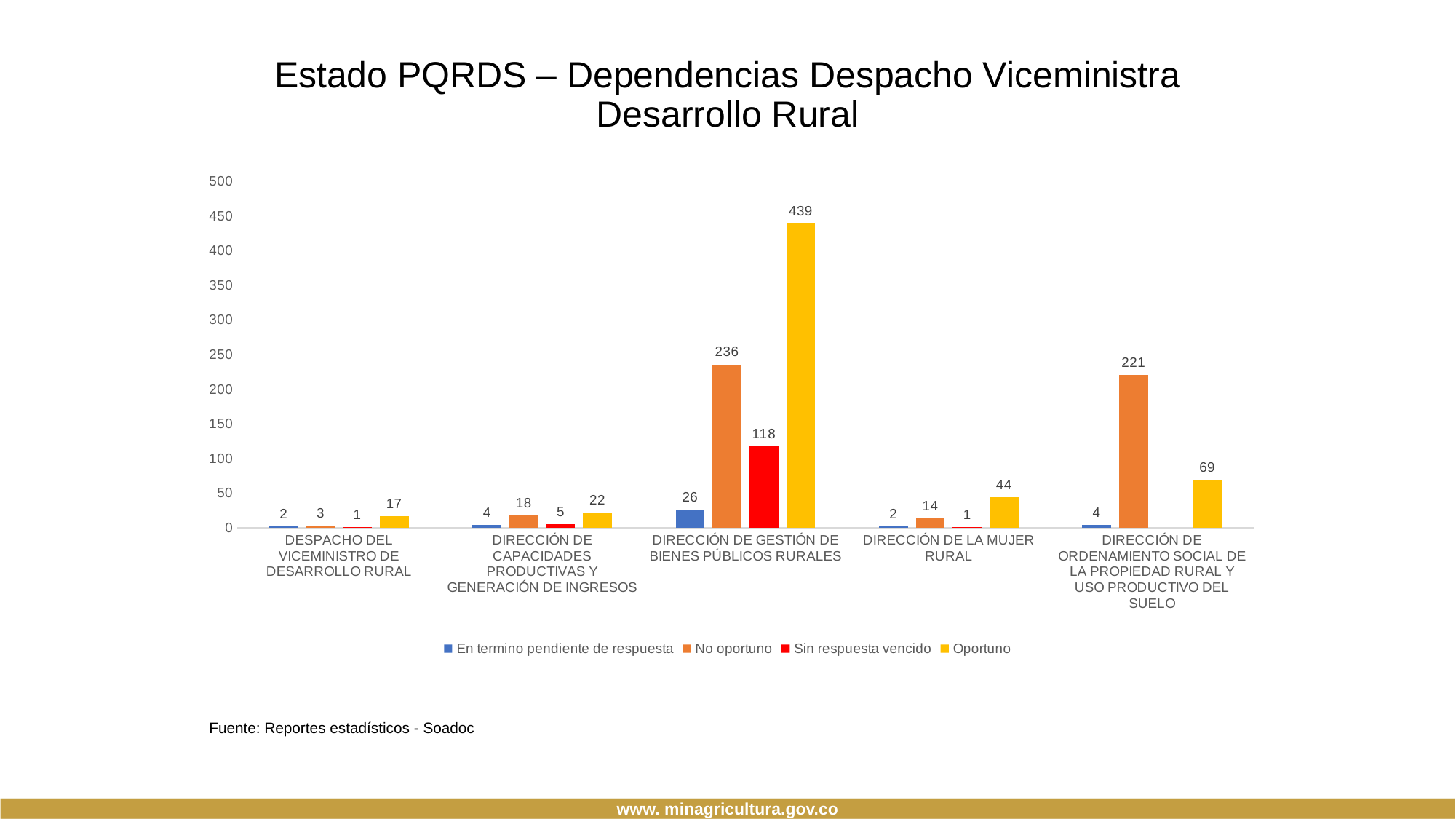
How many series does the legend list? 4 What is the Sin respuesta vencido value for DIRECCIÓN DE GESTIÓN DE BIENES PÚBLICOS RURALES? 118 What is the No oportuno value for DIRECCIÓN DE ORDENAMIENTO SOCIAL DE LA PROPIEDAD RURAL Y USO PRODUCTIVO DEL SUELO? 221 What is the difference between the Oportuno and No oportuno values for DIRECCIÓN DE GESTIÓN DE BIENES PÚBLICOS RURALES? 203 Which series is shown in red in the legend? Sin respuesta vencido How many dependencies (categories) are shown on the x axis? 5 Which dependency has the lowest No oportuno value? DESPACHO DEL VICEMINISTRO DE DESARROLLO RURAL What is the Oportuno value for DIRECCIÓN DE GESTIÓN DE BIENES PÚBLICOS RURALES? 439 What is the Oportuno value for DIRECCIÓN DE LA MUJER RURAL? 44 Which dependency has the highest Oportuno value? DIRECCIÓN DE GESTIÓN DE BIENES PÚBLICOS RURALES Which is larger for DIRECCIÓN DE ORDENAMIENTO SOCIAL DE LA PROPIEDAD RURAL Y USO PRODUCTIVO DEL SUELO: No oportuno or Oportuno? No oportuno What type of chart is shown on the slide? Bar chart